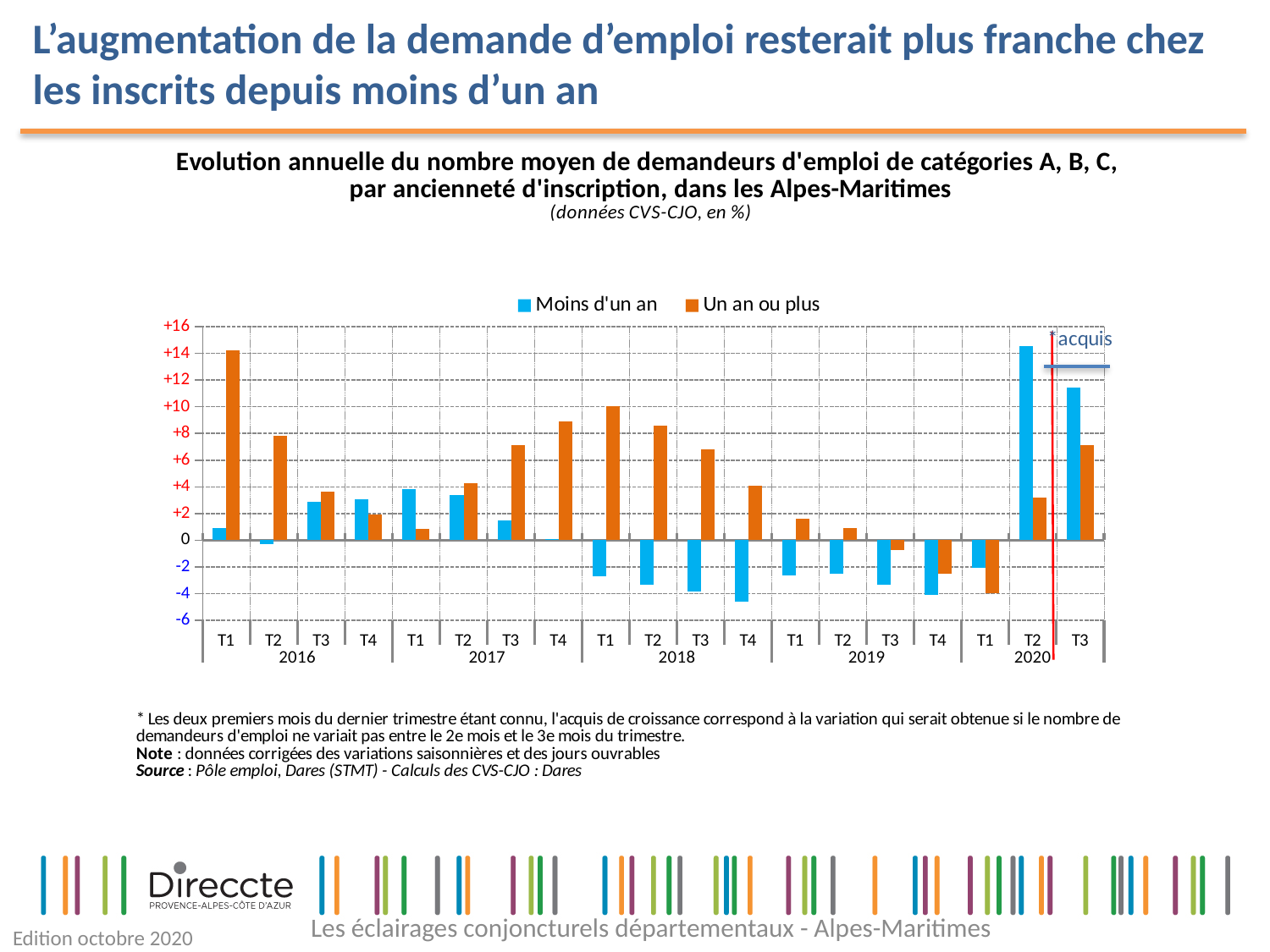
In T2 2020, which series has the larger value, 'Moins d'un an' or 'Un an ou plus'? Moins d'un an How many quarters are plotted along the x axis? 19 In which quarter is the value for 'Moins d'un an' highest? T2 2020 Which colour represents the 'Un an ou plus' series? orange What kind of chart is shown on the slide? bar chart How many series does the legend list? 2 In which quarter is the value for 'Un an ou plus' lowest? T1 2020 Is the value for 'Un an ou plus' in T1 2018 greater or less than +8? greater In which quarter is the value for 'Un an ou plus' highest? T1 2016 Is the value for 'Moins d'un an' in T2 2020 greater or less than +12? greater Is the value for 'Moins d'un an' in T4 2018 greater or less than -2? less